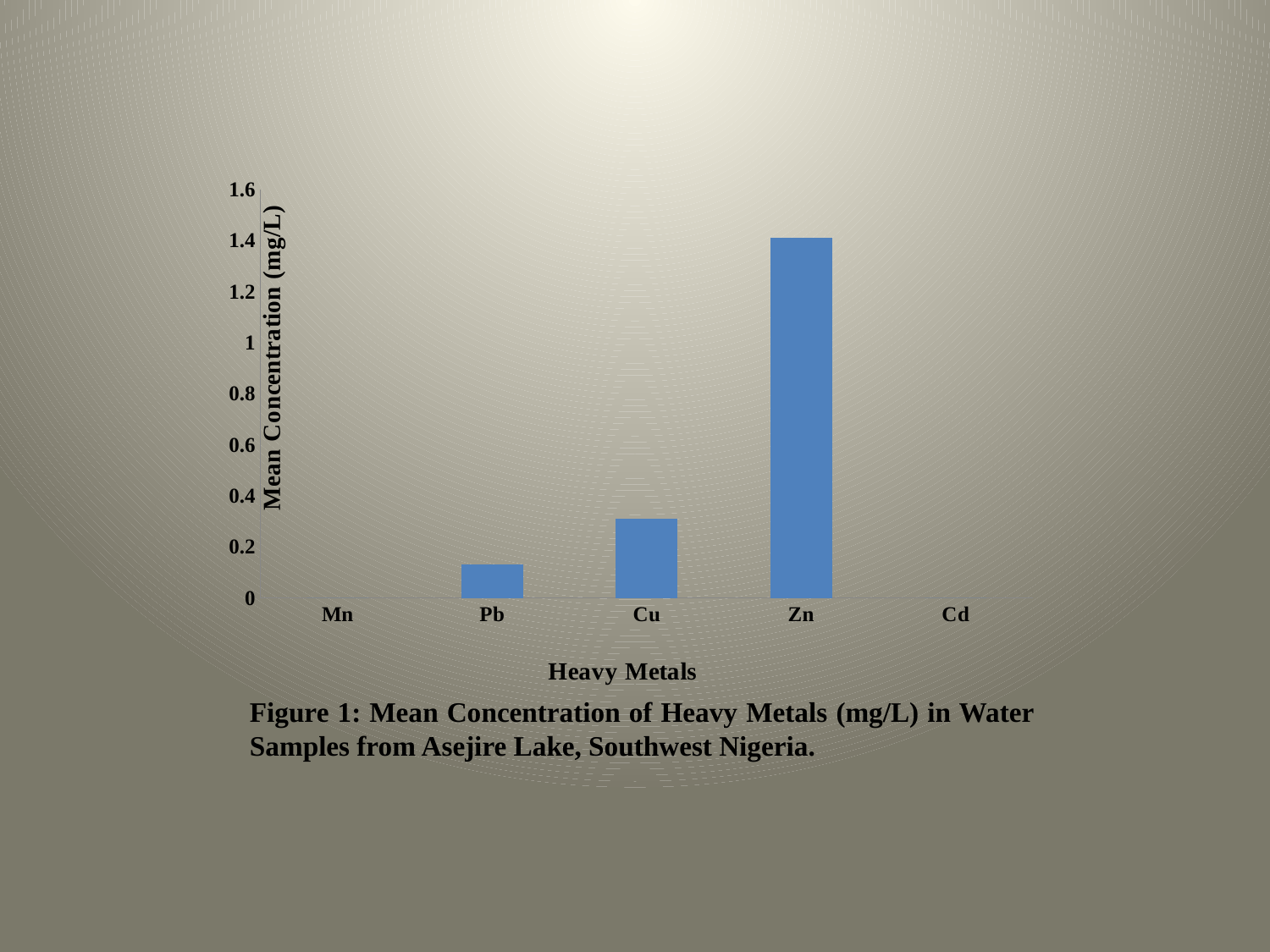
What is the label of the x axis of the chart? Heavy Metals What kind of chart is shown on the slide? Bar chart Is the mean concentration for Cu greater or less than 0.2 mg/L? greater How many heavy metals are shown on the x axis of the chart? 5 Is the mean concentration for Pb greater or less than 0.2 mg/L? less What is the label of the y axis of the chart? Mean Concentration (mg/L) Which has a higher mean concentration, Cu or Pb? Cu Which heavy metal has the highest mean concentration in the chart? Zn Is the mean concentration for Zn greater or less than 1.6 mg/L? less Which has a higher mean concentration, Zn or Cu? Zn